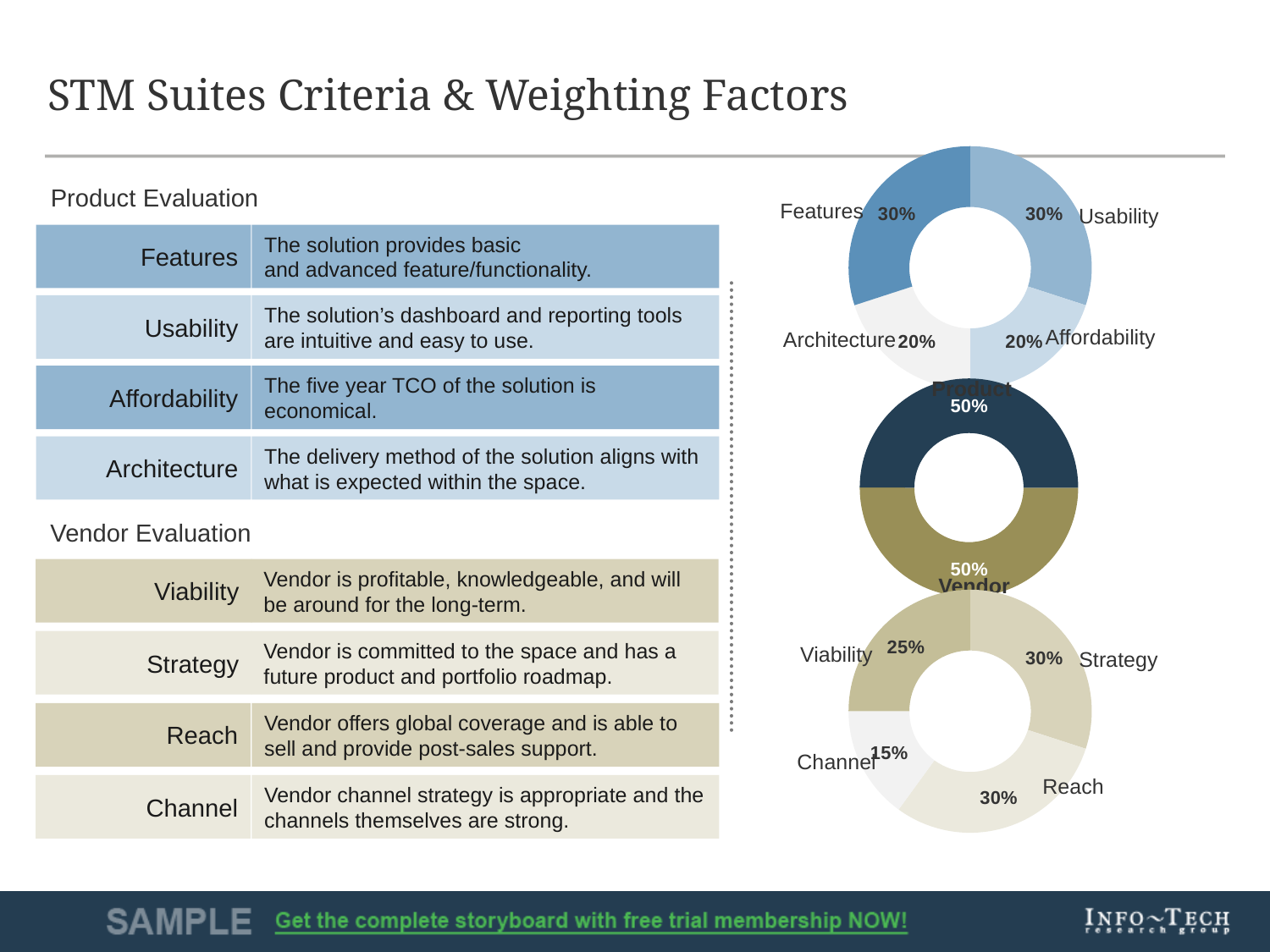
In the top donut chart, what is the value for Architecture? 20% In the bottom donut chart, what is the difference between the Reach value and the Channel value? 15% What kind of chart is the top chart on the slide? Donut (pie) chart In the middle donut chart, how many slices are there? 2 In the middle donut chart, what is the value for Vendor? 50% In the bottom donut chart, which is larger, Viability or Strategy? Strategy In the top donut chart, what is the value for Usability? 30% In the bottom donut chart, what is the value for Viability? 25% In the bottom donut chart, what is the value for Channel? 15% In the top donut chart, what is the difference between the Features value and the Affordability value? 10% In the bottom donut chart, which category has the lowest value? Channel In the top donut chart, how many slices are there? 4